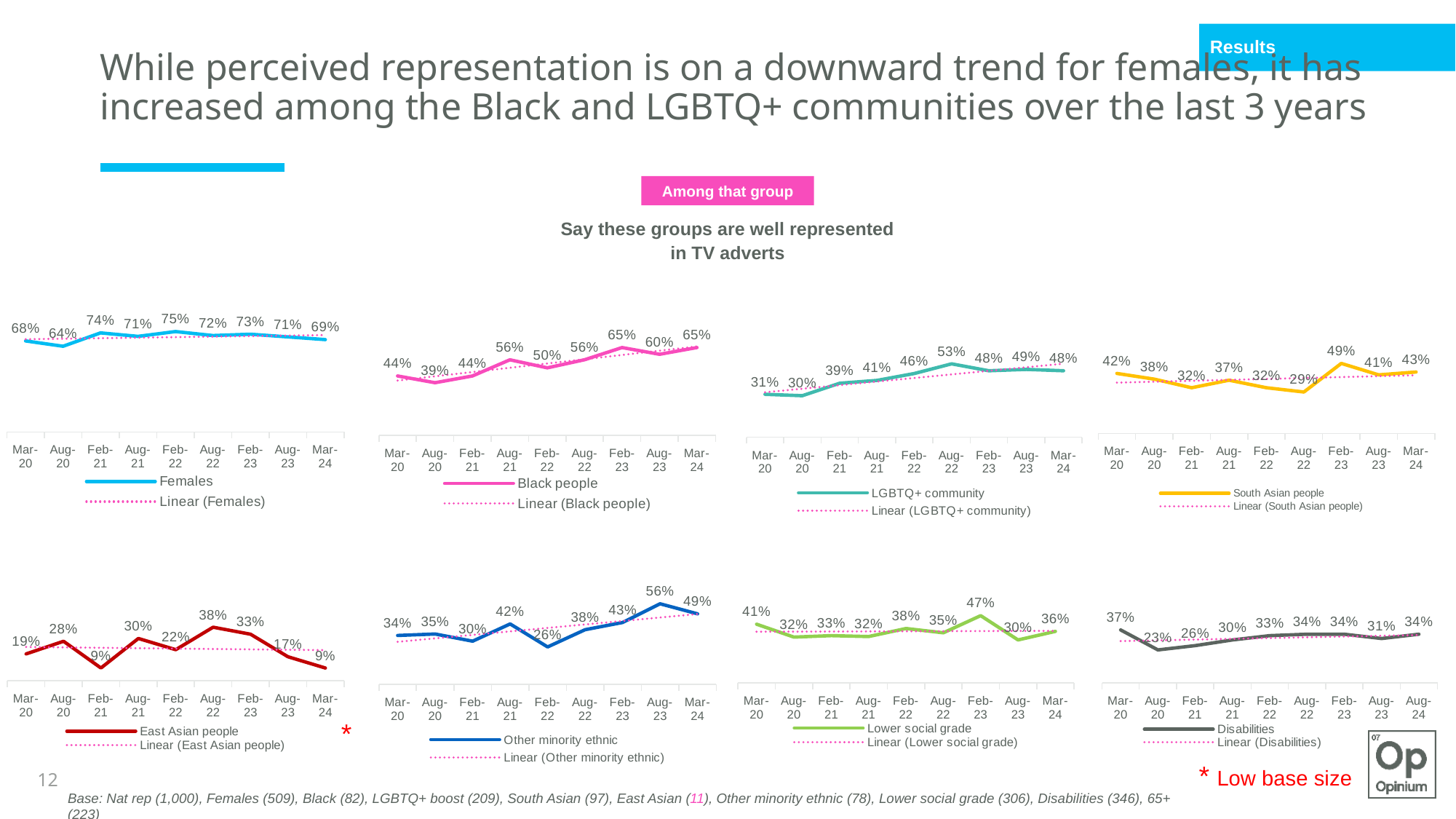
In the Black people chart, do the values generally rise or fall from Mar-20 to Mar-24? Rise How many time points are plotted in the Females chart? 9 In the Females chart, what percentage said females are well represented in TV adverts in Mar-24? 69% What type of chart is used for the Black people data? Line chart In the Other minority ethnic chart, what is the difference between the Aug-23 value and the Mar-24 value? 7% In the East Asian people chart, what is the lowest value shown? 9% In the LGBTQ+ community chart, what is the value for Aug-22? 53% How many entries does the legend of the LGBTQ+ community chart list? 2 In the South Asian people chart, which period has the highest value? Feb-23 In the Disabilities chart, what is the value for Mar-20? 37% In the Black people chart, what is the value for Feb-23? 65% In the Lower social grade chart, which is larger: the value for Mar-20 or the value for Mar-24? Mar-20